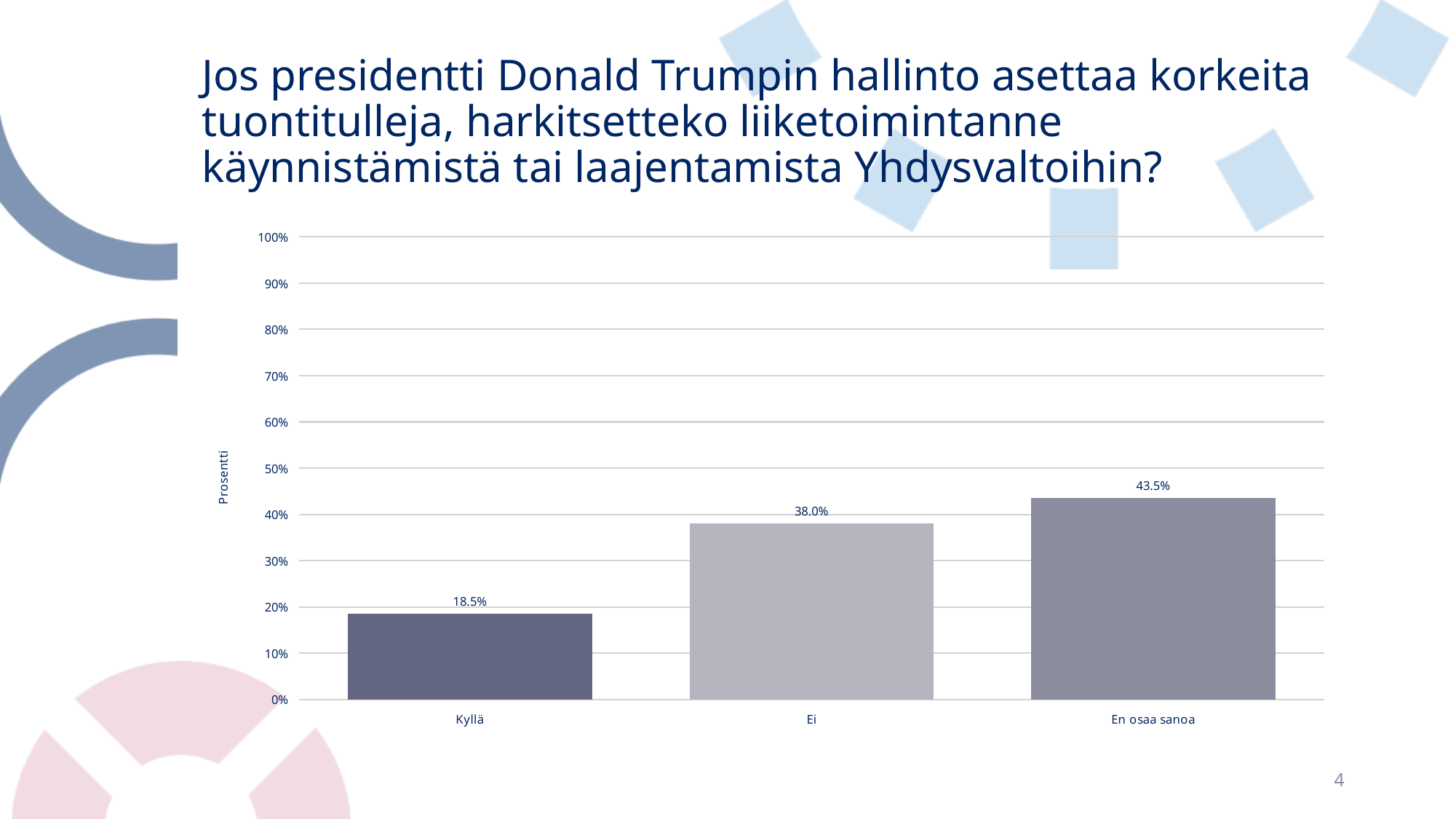
What is the difference between the values for Ei and Kyllä? 19.5% What is the difference between the values for En osaa sanoa and Ei? 5.5% What kind of chart is shown on the slide? bar chart Which category has the highest value? En osaa sanoa Which is larger, the value for Ei or the value for Kyllä? Ei Is the value for En osaa sanoa greater or less than 50%? less What is the label of the vertical axis? Prosentti How many categories are shown on the x axis? 3 Which category has the lowest value? Kyllä What is the value for En osaa sanoa? 43.5% What is the value for Kyllä? 18.5% What is the value for Ei? 38.0%